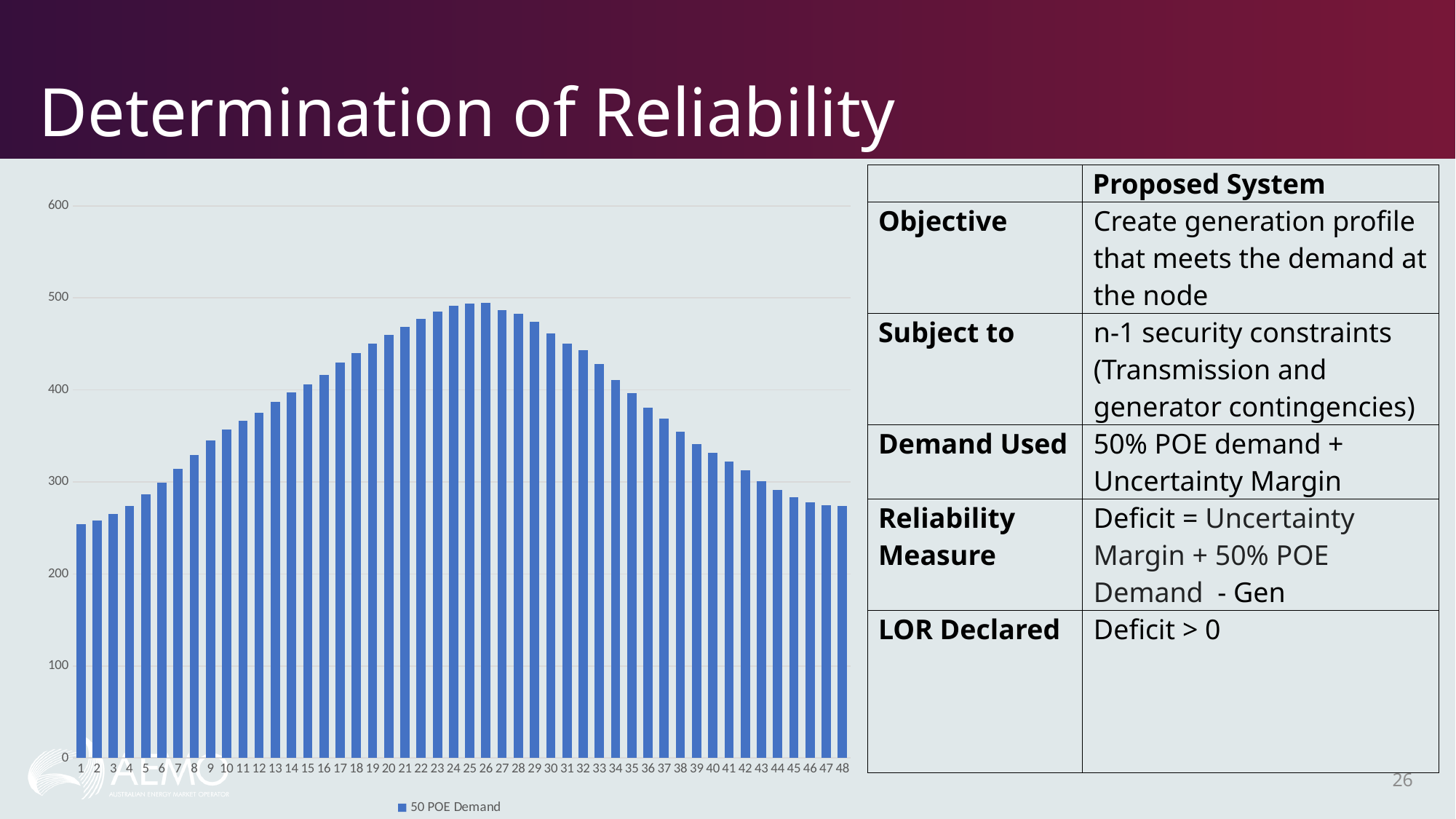
How many categories are plotted along the x axis of the chart? 48 Is the value for category 48 greater or less than 300? less Is the value for category 25 greater or less than 400? greater What is the highest value shown on the chart's vertical axis? 600 Is the value for category 20 greater or less than 400? greater What kind of chart is shown on the slide? bar chart How many series does the chart's legend list? 1 Do the values rise or fall from category 1 to category 25? rise Which has the larger value, category 25 or category 48? 25 Do the values rise or fall from category 26 to category 48? fall What is the name of the series shown in the chart's legend? 50 POE Demand